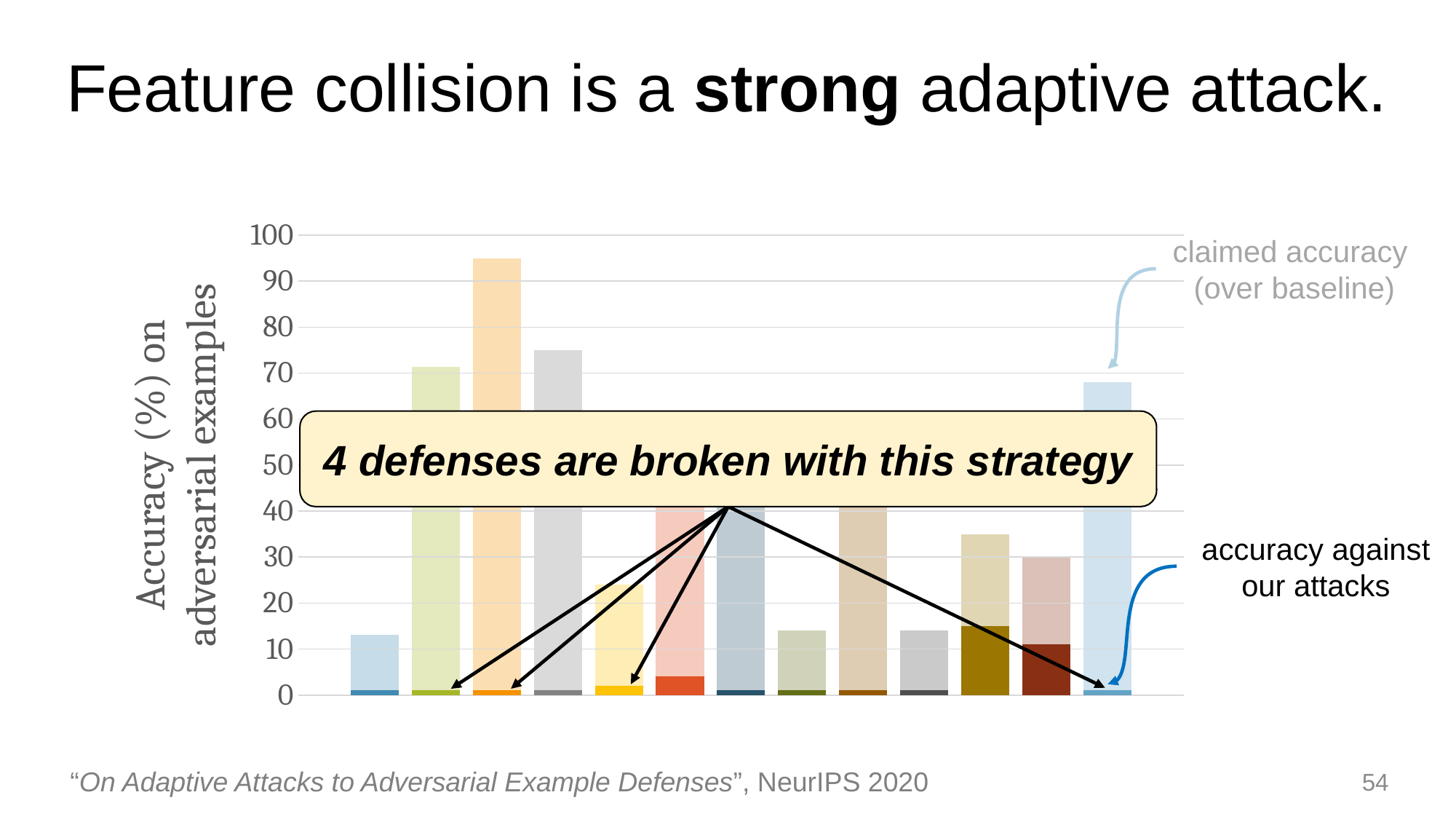
What is the highest value shown on the y axis of the chart? 100 Is the claimed accuracy of the leftmost bar in the chart greater or less than 20? less What kind of chart is shown on the slide? bar chart Which is taller in the chart: the leftmost bar or the rightmost bar? the rightmost bar Is the claimed accuracy of the tallest bar in the chart greater or less than 90? greater Is the claimed accuracy of the rightmost bar in the chart greater or less than 60? greater According to the annotations, what do the tall, lightly shaded bars represent? claimed accuracy (over baseline) What is the label of the y axis of the chart? Accuracy (%) on adversarial examples How many bars (defenses) are plotted along the x axis of the chart? 13